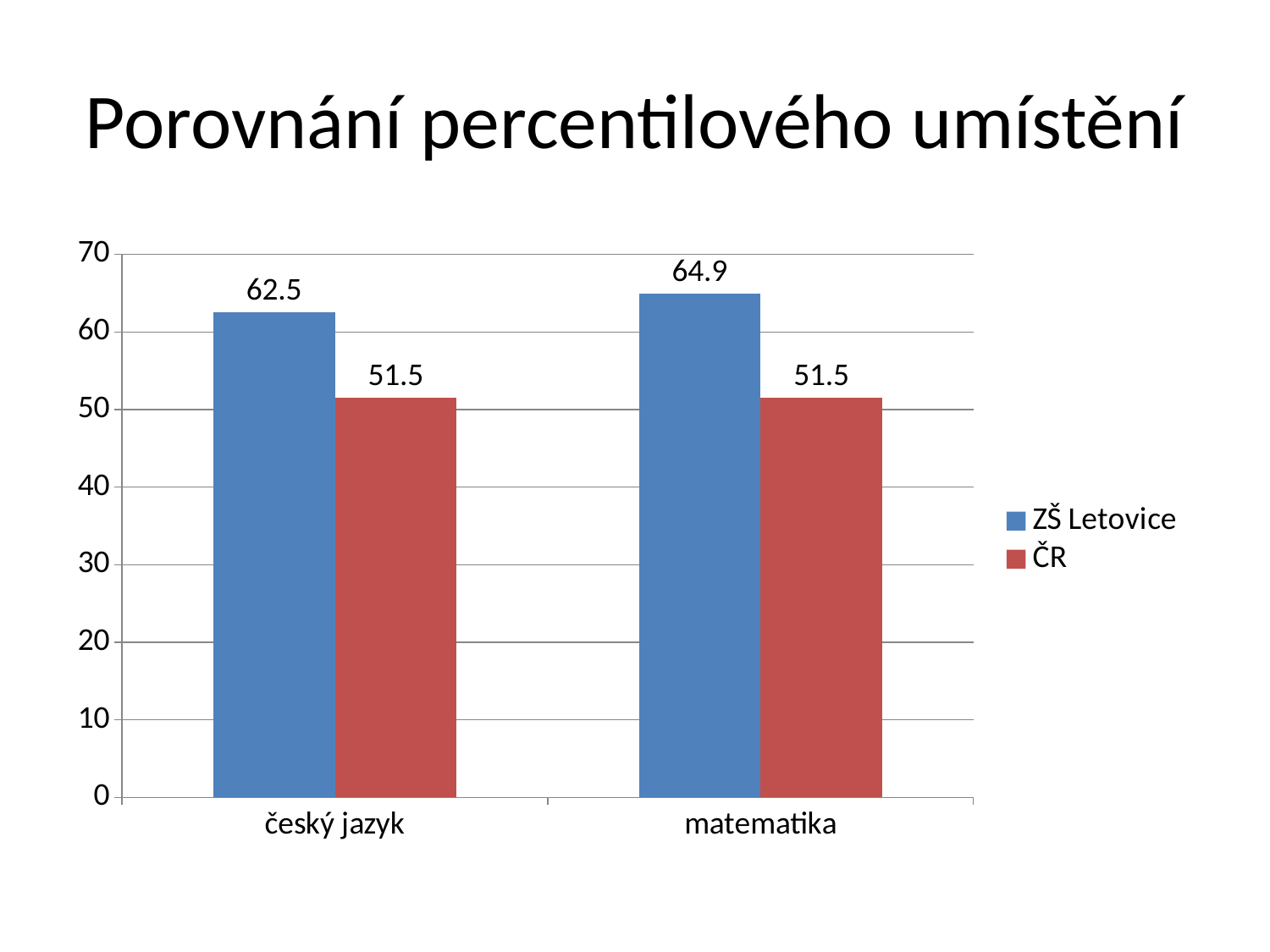
What is the difference between ZŠ Letovice and ČR in matematika? 13.4 What is the title of the slide? Porovnání percentilového umístění Which category has the highest value for ZŠ Letovice? matematika How many categories are shown on the x axis? 2 Is the value for ZŠ Letovice in matematika greater or less than 60? greater What is the value for ZŠ Letovice in český jazyk? 62.5 What kind of chart is shown on the slide? bar chart What is the difference between ZŠ Letovice and ČR in český jazyk? 11 What is the value for ČR in matematika? 51.5 How many series does the legend list? 2 What is the value for ZŠ Letovice in matematika? 64.9 Which is larger in český jazyk, ZŠ Letovice or ČR? ZŠ Letovice